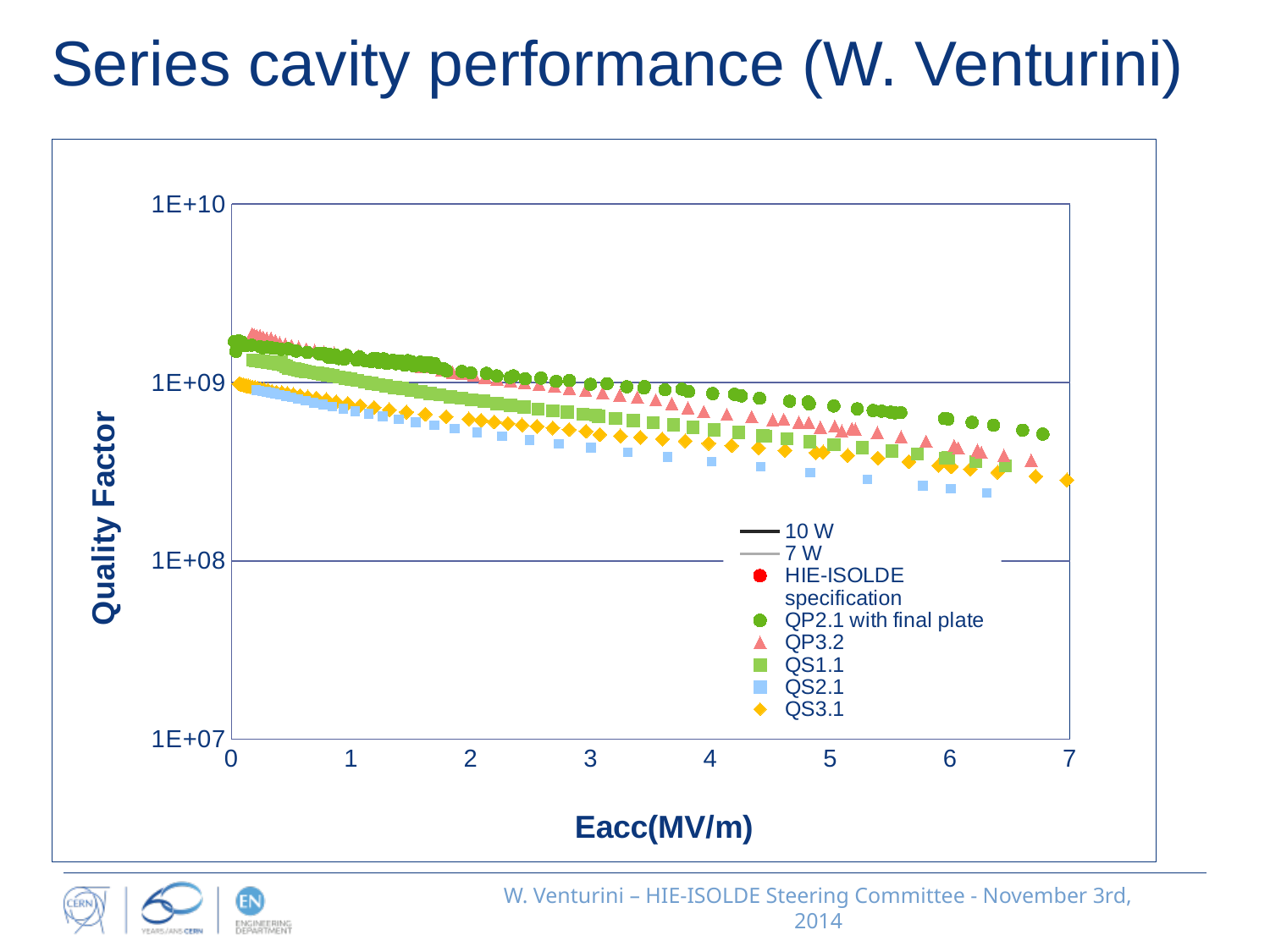
Is the quality factor for QS2.1 at Eacc of 6 MV/m greater or less than 1E+09? less What is the label of the y axis? Quality Factor Which cavity series has the highest quality factor at Eacc of 6 MV/m? QP2.1 with final plate Is the quality factor for QS3.1 at Eacc of 7 MV/m greater or less than 1E+08? greater At Eacc of 3 MV/m, which series has the higher quality factor, QS1.1 or QS3.1? QS1.1 What kind of chart is shown on the slide? scatter chart How many entries does the chart legend list? 8 Is the quality factor for QP2.1 with final plate at Eacc of 1 MV/m greater or less than 1E+09? greater What marker shape and colour does the legend use for QS3.1? yellow diamonds Do the quality factor values for the cavities rise or fall as Eacc increases along the x axis? fall Which cavity series has the lowest quality factor at Eacc of 6 MV/m? QS2.1 At Eacc of 5 MV/m, which series has the higher quality factor, QP2.1 with final plate or QS2.1? QP2.1 with final plate